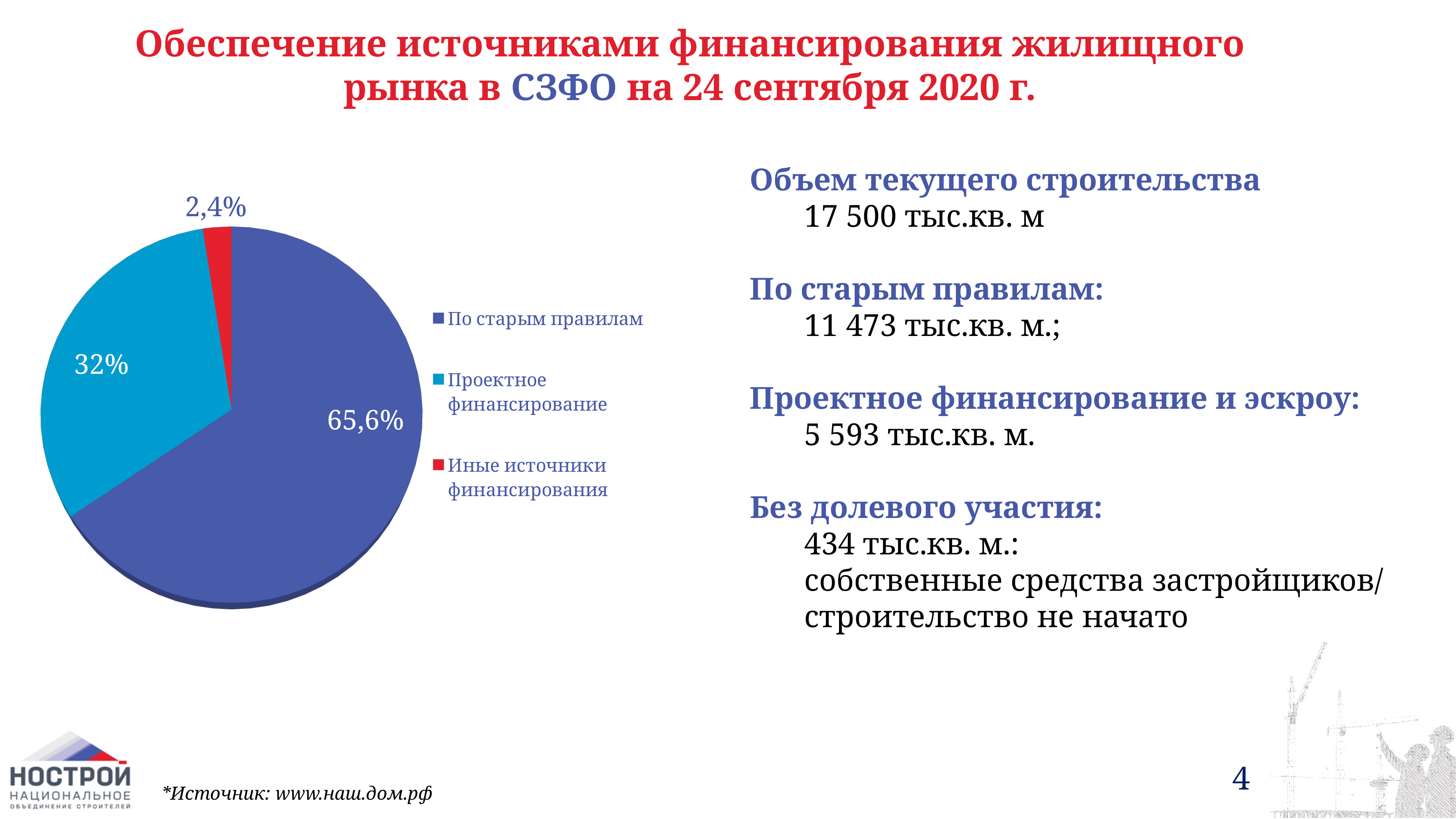
What colour is the slice for "Иные источники финансирования"? Red How many slices does the pie chart have? 3 What share of the pie does "По старым правилам" have? 65,6% Which is larger: the slice for "Проектное финансирование" or the slice for "Иные источники финансирования"? Проектное финансирование Which category has the smallest slice of the pie? Иные источники финансирования What colour is the slice for "Проектное финансирование"? Light blue What share of the pie does "Проектное финансирование" have? 32% Which category has the largest slice of the pie? По старым правилам What share of the pie does "Иные источники финансирования" have? 2,4% How many entries does the legend list? 3 What is the difference in percentage points between "По старым правилам" and "Проектное финансирование"? 33,6 What kind of chart is shown on the slide? Pie chart